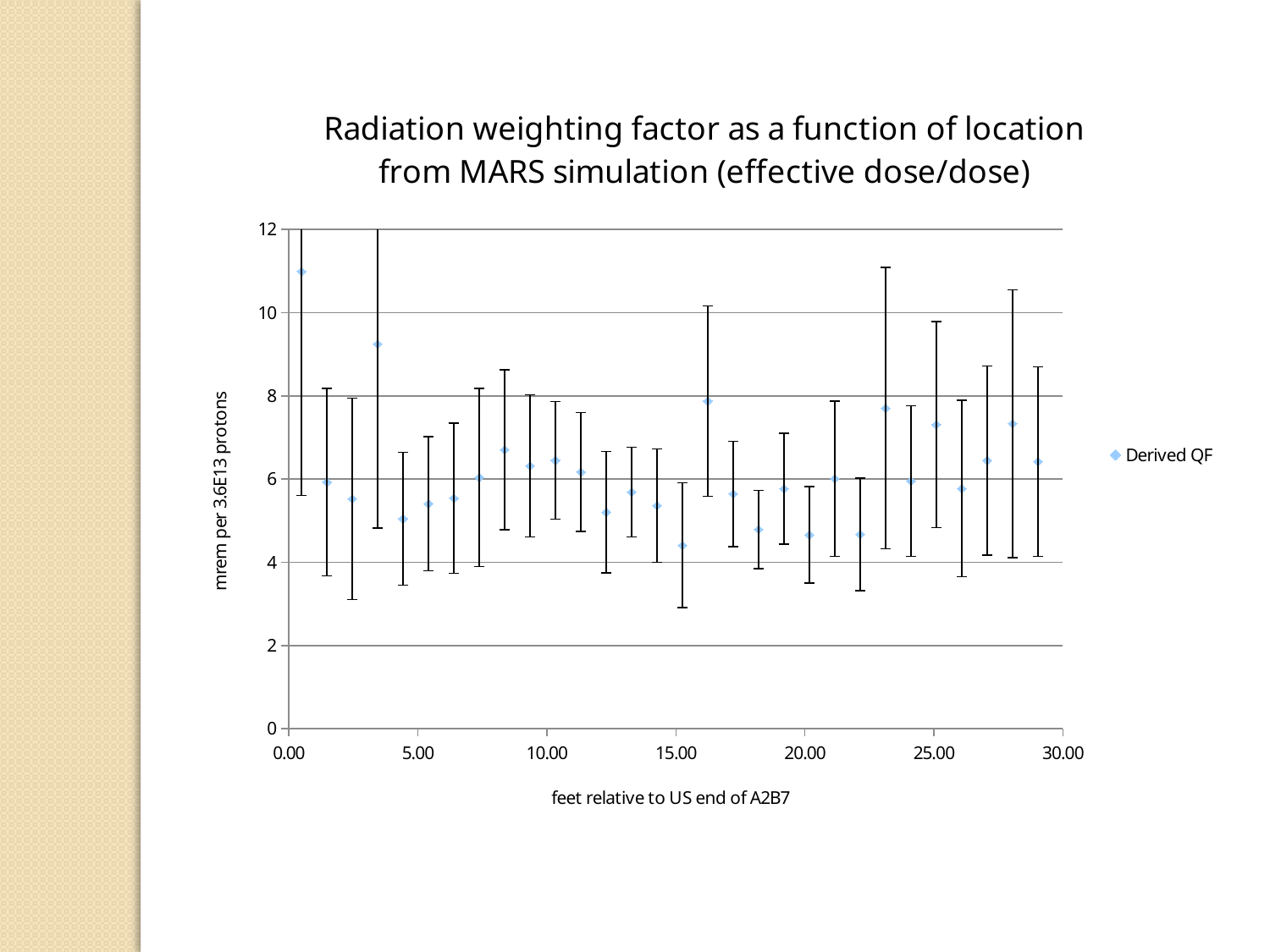
Is the Derived QF value for the point near 3.5 feet greater or less than 8? greater Which has the larger Derived QF value: the point near 0.5 feet or the point near 15 feet? the point near 0.5 feet Is the Derived QF value for the point near 15 feet greater or less than 6? less What kind of chart is shown on the slide? scatter chart What is the title of the x axis? feet relative to US end of A2B7 How many series does the legend list? 1 Is the Derived QF value for the first point (near 0.5 feet) greater or less than 10? greater What is the name of the series shown in the legend? Derived QF